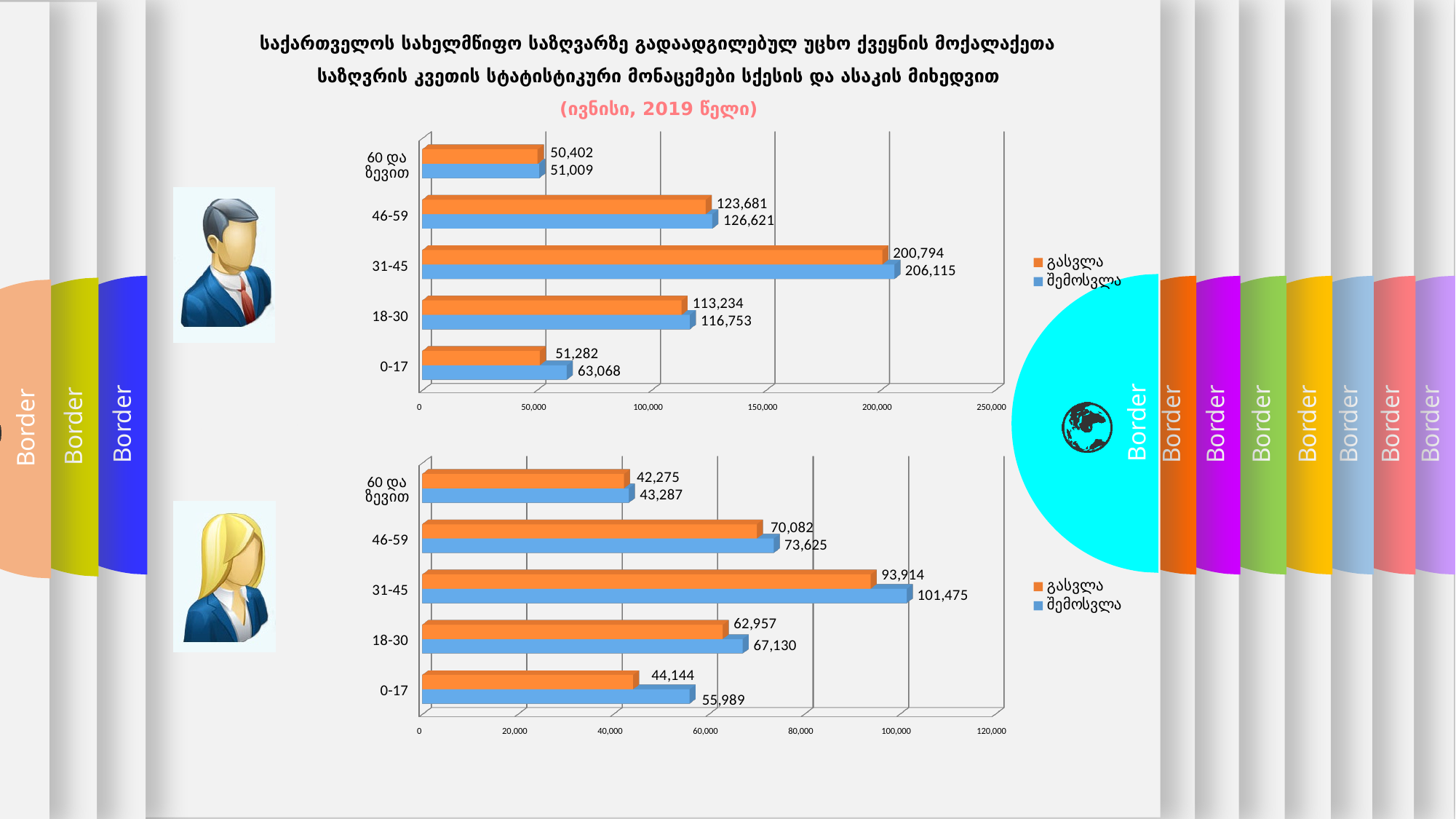
In the bottom chart, which is larger for the 46-59 age group: გასვლა or შემოსვლა? შემოსვლა How many age groups are shown in the bottom chart? 5 What type of chart is the bottom chart? bar chart In the top chart, what is the difference between შემოსვლა and გასვლა for the 0-17 age group? 11,786 In the top chart, is the შემოსვლა value for the 46-59 age group greater or less than 100,000? greater In the top chart, what is the value of შემოსვლა for the 31-45 age group? 206,115 In the bottom chart, what is the difference between შემოსვლა and გასვლა for the 31-45 age group? 7,561 In the bottom chart, which age group has the highest გასვლა value? 31-45 How many series does the legend of the top chart list? 2 In the top chart, what is the value of გასვლა for the 0-17 age group? 51,282 In the top chart, which age group has the lowest გასვლა value? 60 და ზევით In the bottom chart, what is the value of შემოსვლა for the 18-30 age group? 67,130